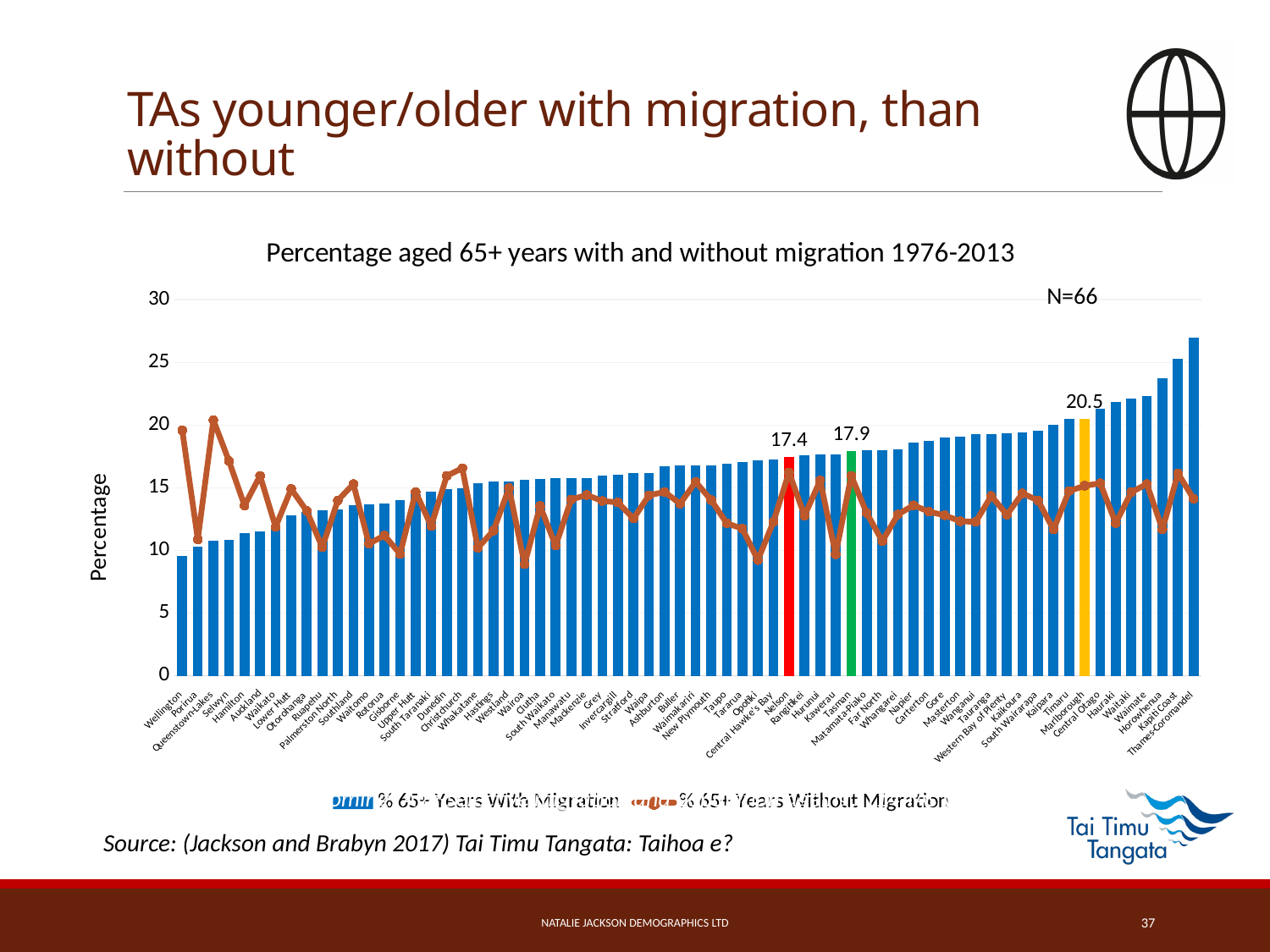
Which TA has the lowest % 65+ Years With Migration bar? Wellington How many series does the legend list? 2 Is the % 65+ Years With Migration bar for Thames-Coromandel greater or less than 25? greater What is the value of the red bar (Nelson) for % 65+ Years With Migration? 17.4 What is the value of the yellow bar (Marlborough) for % 65+ Years With Migration? 20.5 What is the value of the green bar (Tasman) for % 65+ Years With Migration? 17.9 How many TAs are plotted in the chart, according to the N annotation? 66 What kind of chart is used to plot the '% 65+ Years With Migration' series? bar chart Which TA has the highest % 65+ Years With Migration bar? Thames-Coromandel What is the difference between the labelled values of the yellow bar (20.5) and the red bar (17.4)? 3.1 Which is larger, the labelled value of the green bar or the red bar? the green bar (17.9) What is the title of the chart? Percentage aged 65+ years with and without migration 1976-2013